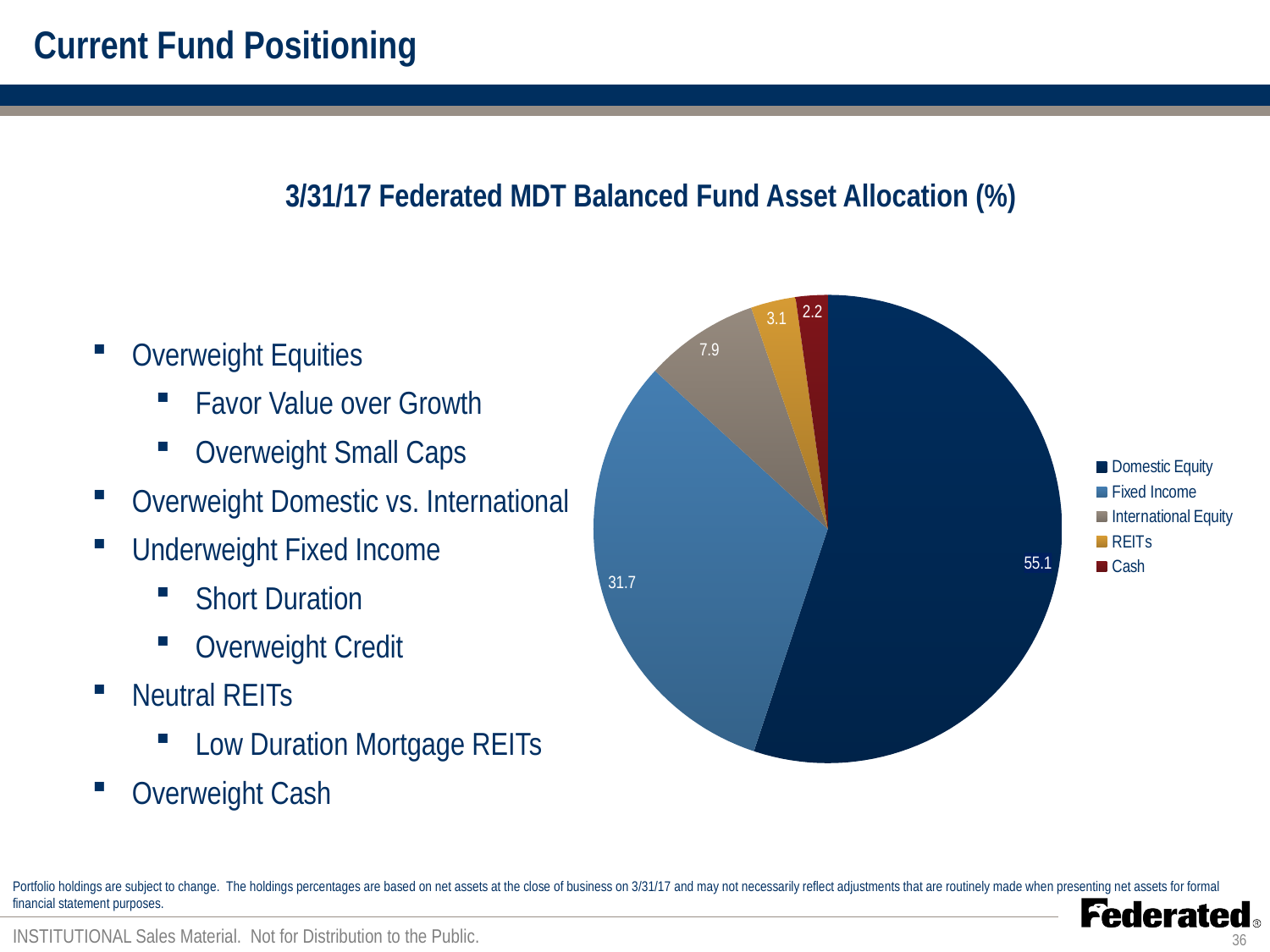
What is the value for Cash? 2.2 What is the value for Fixed Income? 31.7 What is the value for REITs? 3.1 What is the title of the chart? 3/31/17 Federated MDT Balanced Fund Asset Allocation (%) What kind of chart is shown on the slide? Pie chart Which category has the largest share of the pie? Domestic Equity What is the difference between the Domestic Equity and Fixed Income values? 23.4 How many categories does the pie chart show? 5 Which is larger, International Equity or REITs? International Equity What is the value for International Equity? 7.9 What is the value for Domestic Equity? 55.1 Which category has the smallest share of the pie? Cash